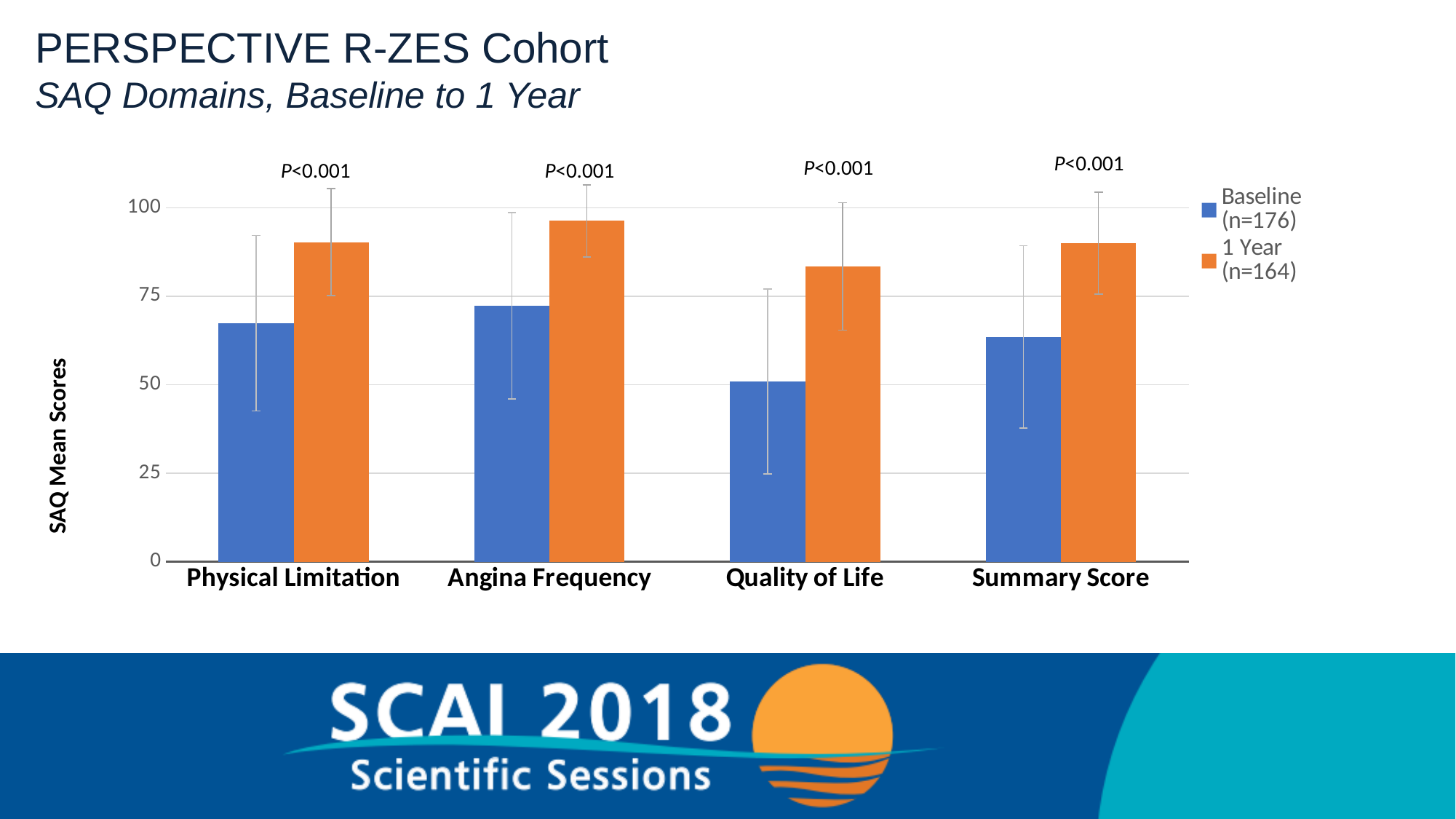
Which category has the lowest 1 Year (n=164) score? Quality of Life Is the Baseline (n=176) value for Quality of Life greater or less than 75? less Which category has the highest 1 Year (n=164) score? Angina Frequency Which category has the lowest Baseline (n=176) score? Quality of Life For Summary Score, which is larger: the Baseline (n=176) value or the 1 Year (n=164) value? 1 Year (n=164) How many SAQ domain categories are shown on the x axis? 4 What kind of chart is shown on the slide? bar chart Is the 1 Year (n=164) value for Angina Frequency greater or less than 75? greater Which is larger: the Baseline (n=176) value for Quality of Life or the Baseline (n=176) value for Summary Score? Summary Score What is the title of the y axis? SAQ Mean Scores Is the Baseline (n=176) value for Physical Limitation greater or less than 50? greater How many series does the legend list? 2